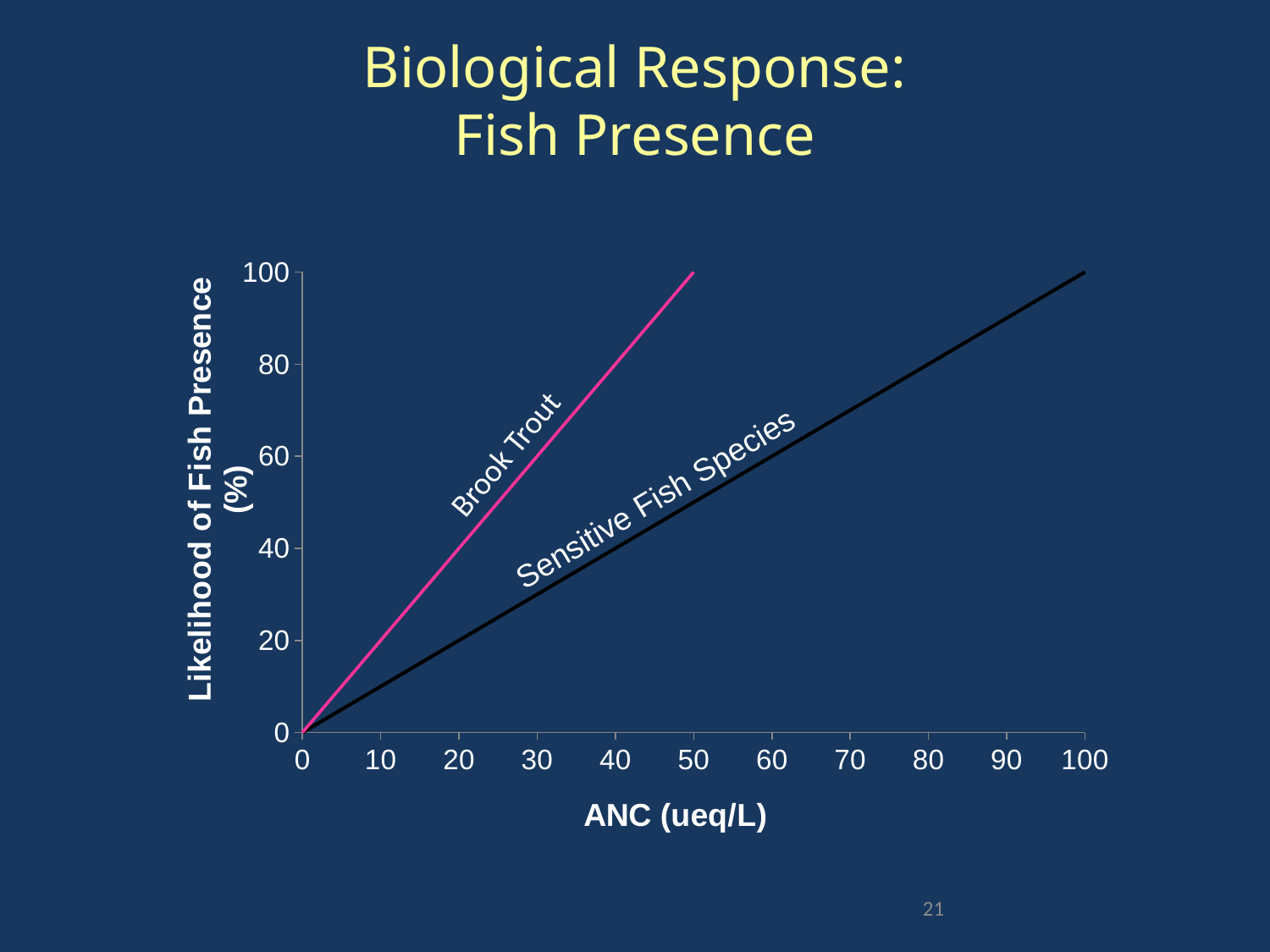
How many series (lines) are plotted on the chart? 2 At an ANC of 30, which line shows the higher likelihood of fish presence, Brook Trout or Sensitive Fish Species? Brook Trout What is the title of the y axis? Likelihood of Fish Presence (%) What is the likelihood of fish presence for Brook Trout at an ANC of 0? 0 Is the likelihood of fish presence for Brook Trout at an ANC of 40 greater or less than 60? greater Which series reaches 100% likelihood at the lower ANC value? Brook Trout At what ANC value does the Brook Trout line reach 100% likelihood of fish presence? 50 Is the likelihood of fish presence for Sensitive Fish Species at an ANC of 30 greater or less than 40? less What kind of chart is shown on the slide? line chart Do the lines rise or fall as ANC increases along the x axis? rise What is the title of the x axis? ANC (ueq/L) At what ANC value does the Sensitive Fish Species line reach 100% likelihood of fish presence? 100